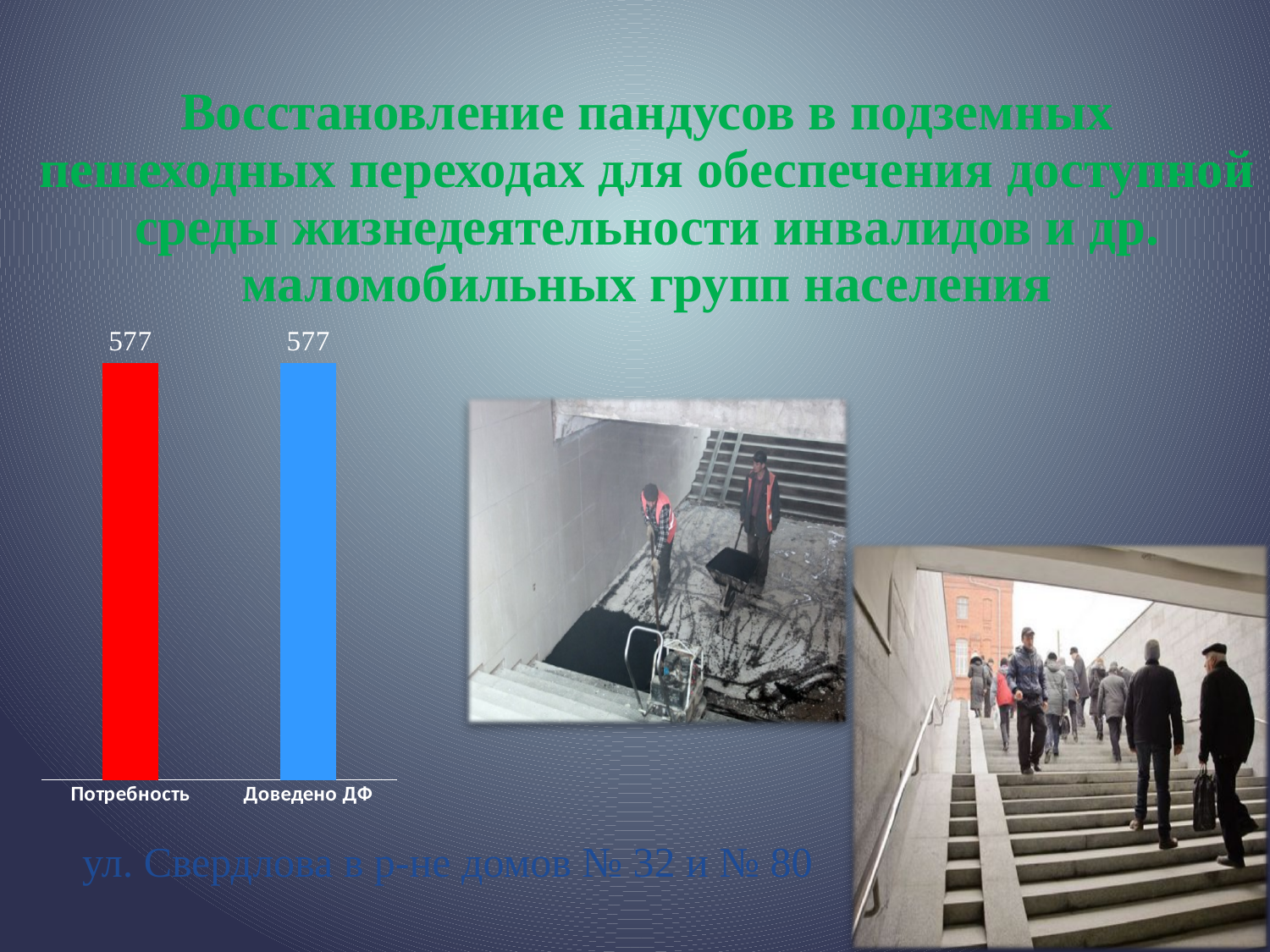
How many bars are plotted in the chart? 2 What kind of chart is shown on the slide? bar chart What colour is the bar for Потребность? red What is the value for Потребность? 577 What is the difference between the values for Потребность and Доведено ДФ? 0 What is the total of the two bar values shown in the chart? 1154 What colour is the bar for Доведено ДФ? blue What is the value for Доведено ДФ? 577